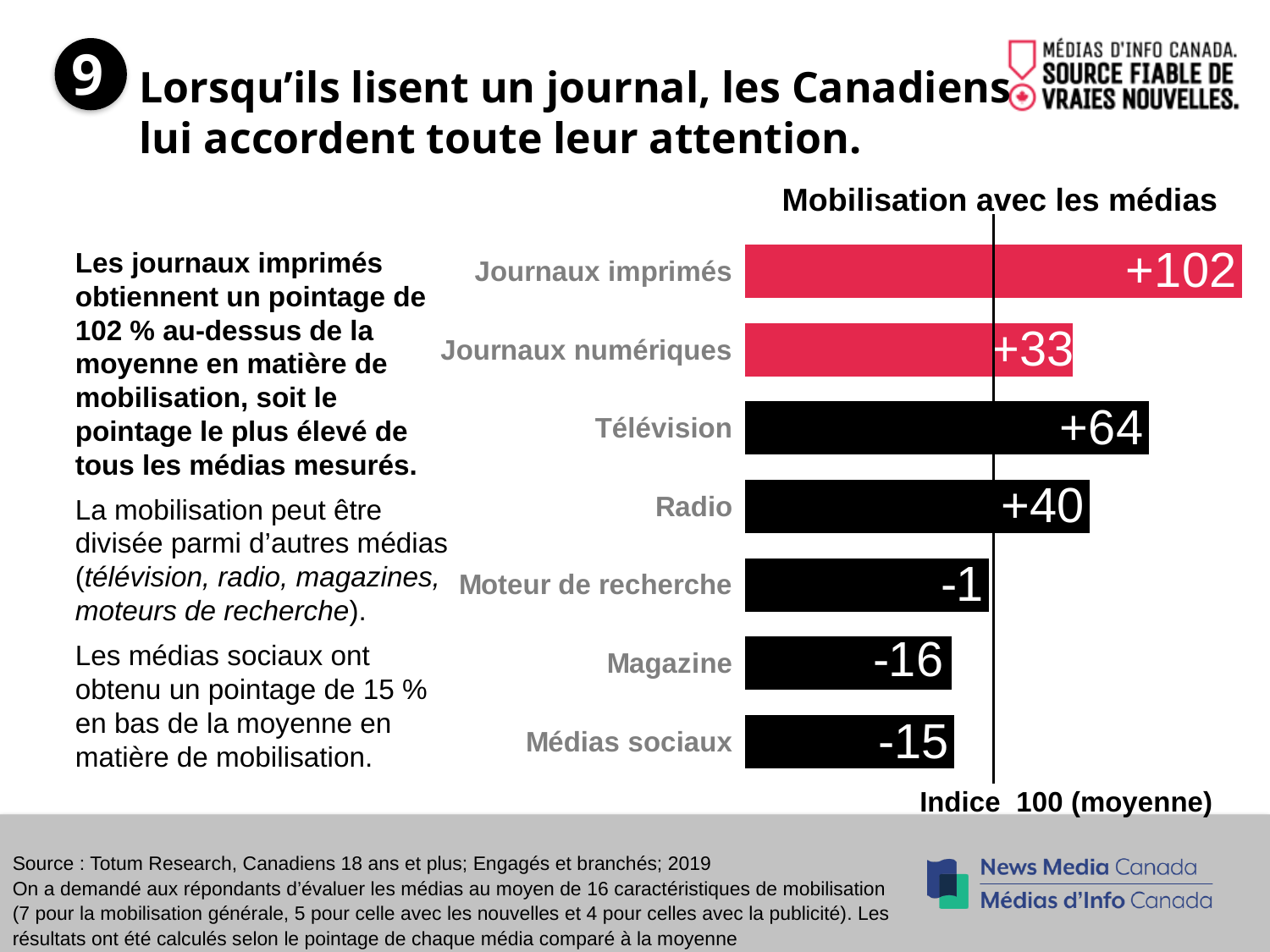
What kind of chart is shown on the slide? Bar chart Which category has the lowest value in the chart? Magazine What is the value for Journaux imprimés in the Mobilisation avec les médias chart? +102 Which categories have red bars in the chart? Journaux imprimés and Journaux numériques What is the title of the chart? Mobilisation avec les médias What is the difference between the values for Journaux imprimés and Journaux numériques? 69 What is the value for Médias sociaux in the chart? -15 What is the value for Télévision in the chart? +64 What is the value for Moteur de recherche in the chart? -1 Which has a larger value, Télévision or Radio? Télévision Which category has the highest value in the chart? Journaux imprimés How many categories are shown in the chart? 7